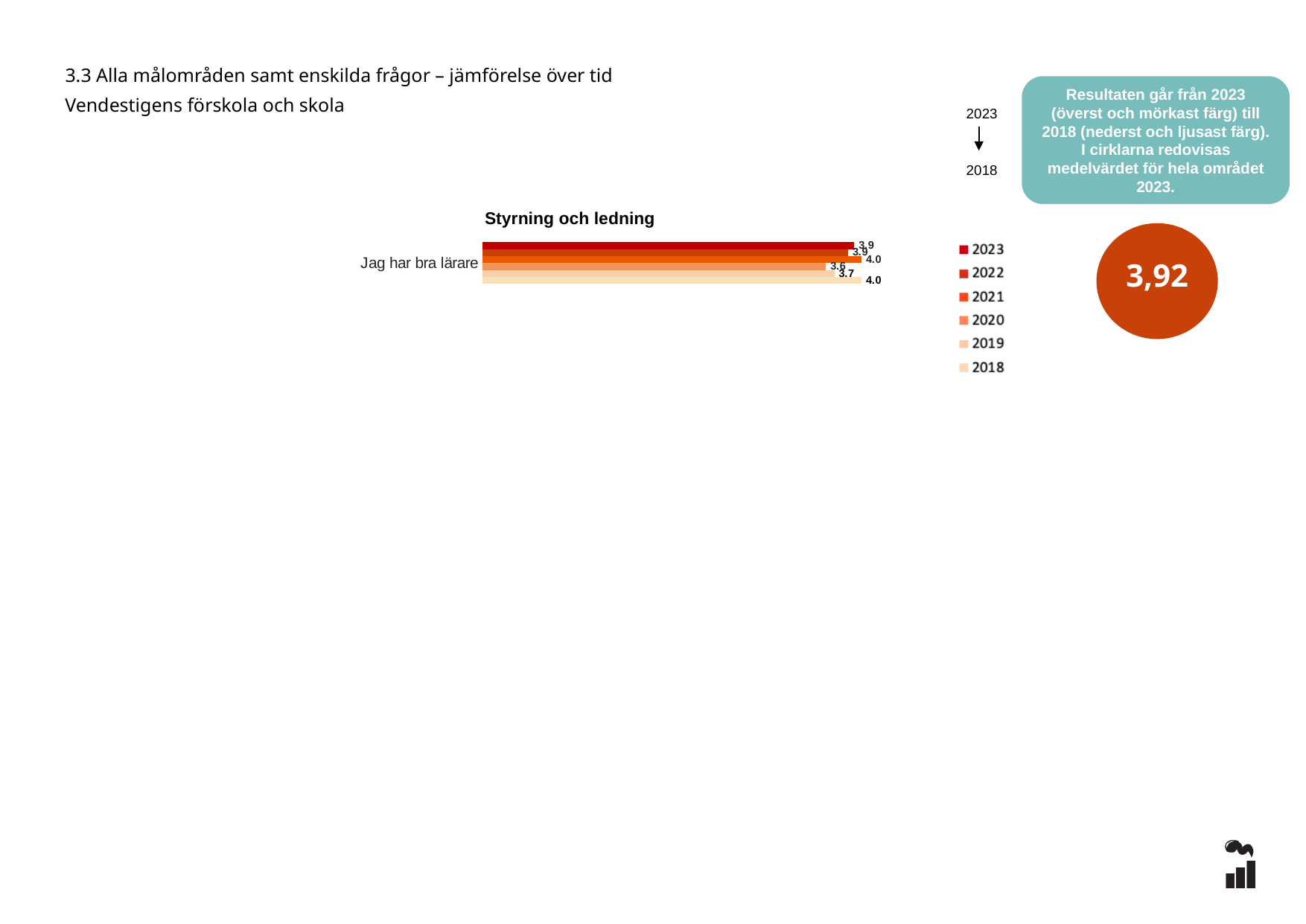
What is the value for 2021 for "Jag har bra lärare" in the Styrning och ledning chart? 4.0 What is the value for 2020 for "Jag har bra lärare" in the Styrning och ledning chart? 3.6 How many categories are plotted in the Styrning och ledning chart? 1 What kind of chart is the Styrning och ledning chart? Bar chart What is the title of the chart on the slide? Styrning och ledning What is the difference between the 2021 and 2020 values for "Jag har bra lärare" in the Styrning och ledning chart? 0.4 What is the value for 2018 for "Jag har bra lärare" in the Styrning och ledning chart? 4.0 How many series does the legend of the Styrning och ledning chart list? 6 Which is larger for "Jag har bra lärare" in the Styrning och ledning chart, the 2019 value or the 2020 value? 2019 What is the value for 2023 for "Jag har bra lärare" in the Styrning och ledning chart? 3.9 Which year has the lowest value for "Jag har bra lärare" in the Styrning och ledning chart? 2020 What is the value for 2019 for "Jag har bra lärare" in the Styrning och ledning chart? 3.7